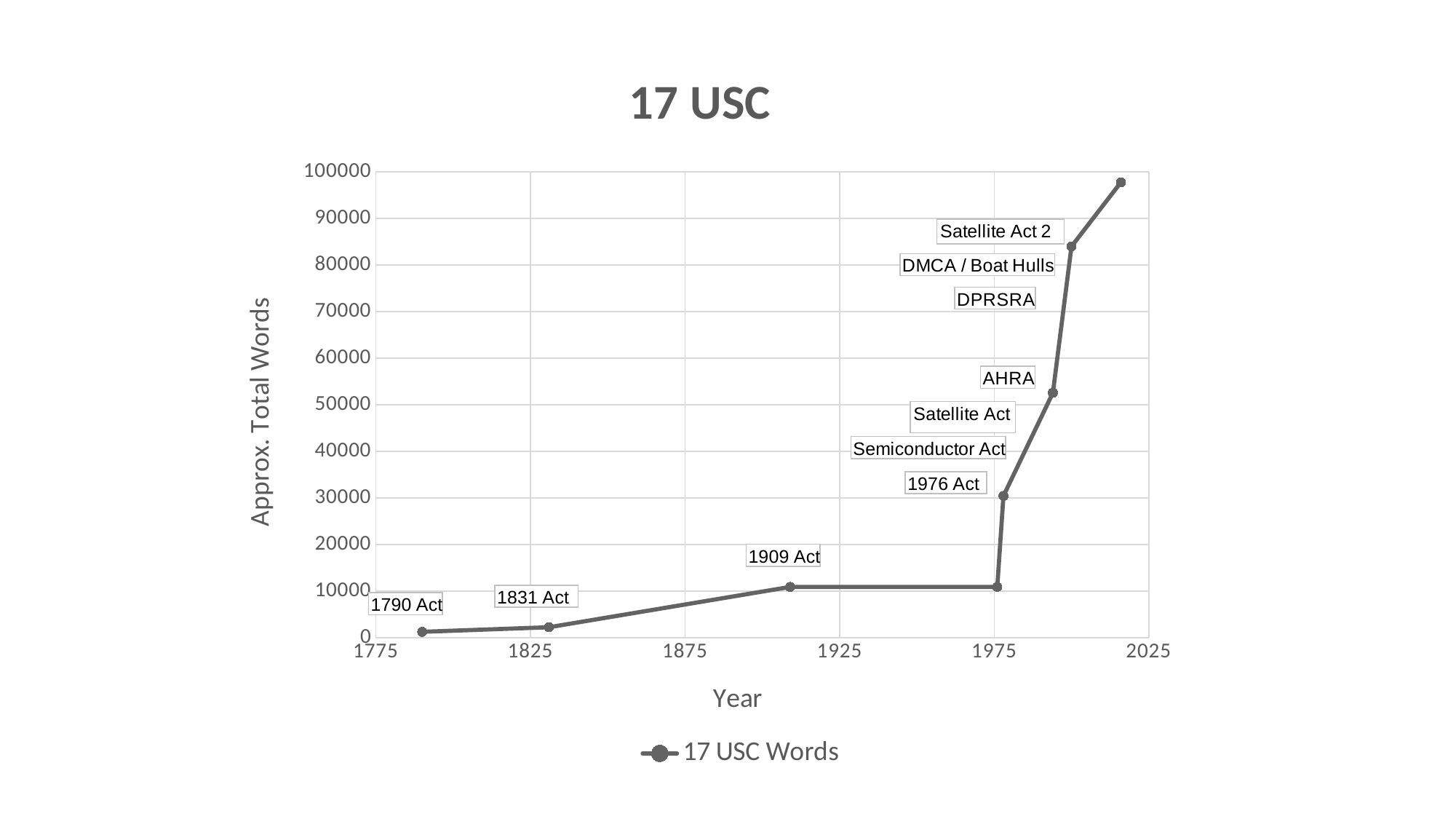
Which is larger, the value at the 1909 Act point or the value at the 1976 Act point? 1976 Act What is the name of the series in the legend? 17 USC Words Is the value at the last plotted point (after 2000) greater or less than 90000? greater Is the value at the 1790 Act point greater or less than 10000? less What kind of chart is shown on the slide? line chart What is the title of the chart? 17 USC How many data points are plotted on the line? 8 Do the values rise or fall as the year increases along the x axis? rise Is the value at the 1831 Act point greater or less than 10000? less How many series does the legend list? 1